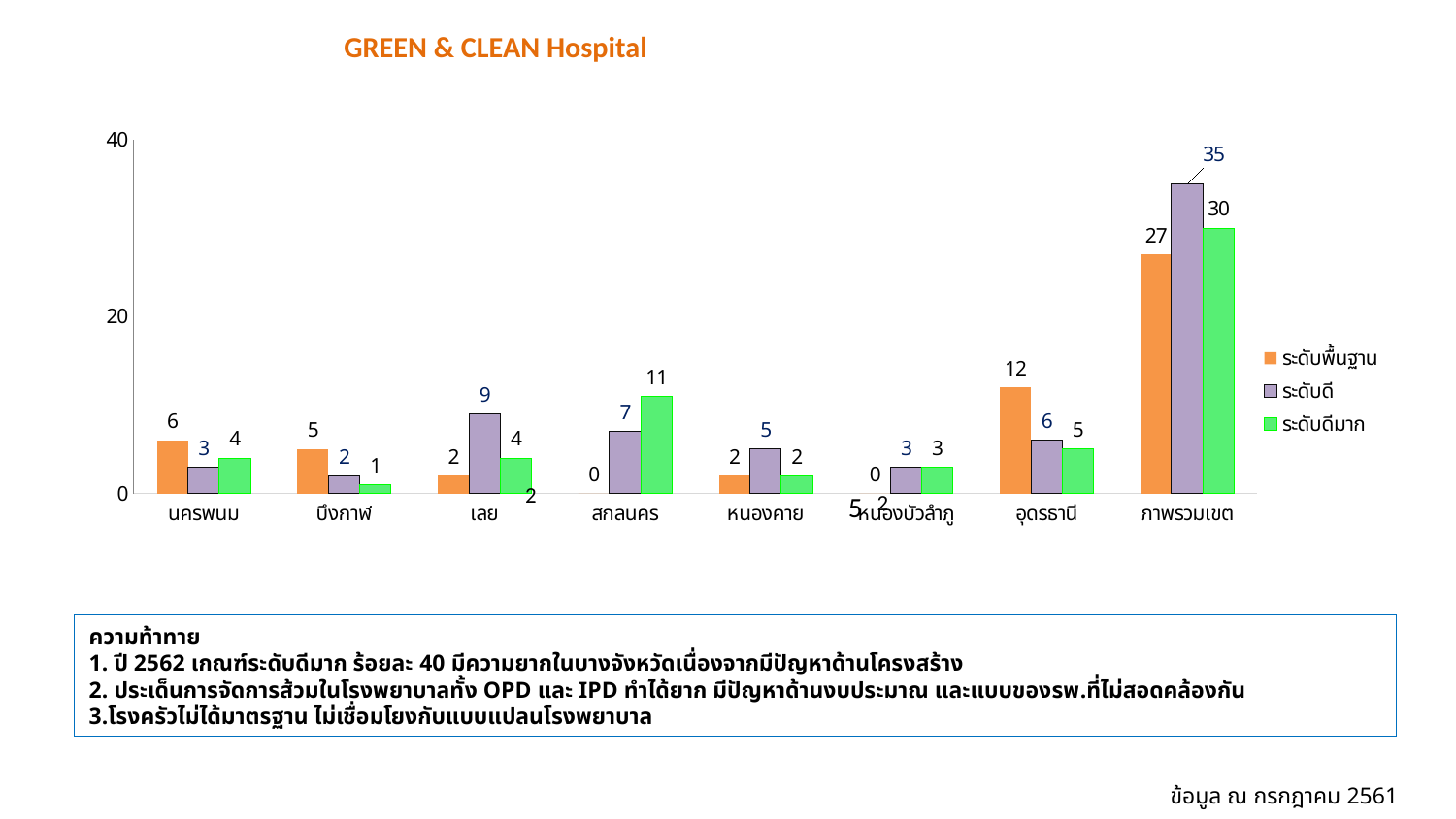
What type of chart is shown on the slide? bar chart How many series does the legend list? 3 How many categories are shown on the x axis? 8 What is the difference between ระดับดี and ระดับพื้นฐาน for ภาพรวมเขต? 8 Which category has the highest ระดับพื้นฐาน value? ภาพรวมเขต What is the value of ระดับดี for ภาพรวมเขต? 35 What is the title of the chart? GREEN & CLEAN Hospital For อุดรธานี, which is larger: ระดับพื้นฐาน or ระดับดี? ระดับพื้นฐาน What is the value of ระดับพื้นฐาน for อุดรธานี? 12 What is the value of ระดับดีมาก for สกลนคร? 11 What is the value of ระดับดี for เลย? 9 Which category has the lowest ระดับดีมาก value? บึงกาฬ